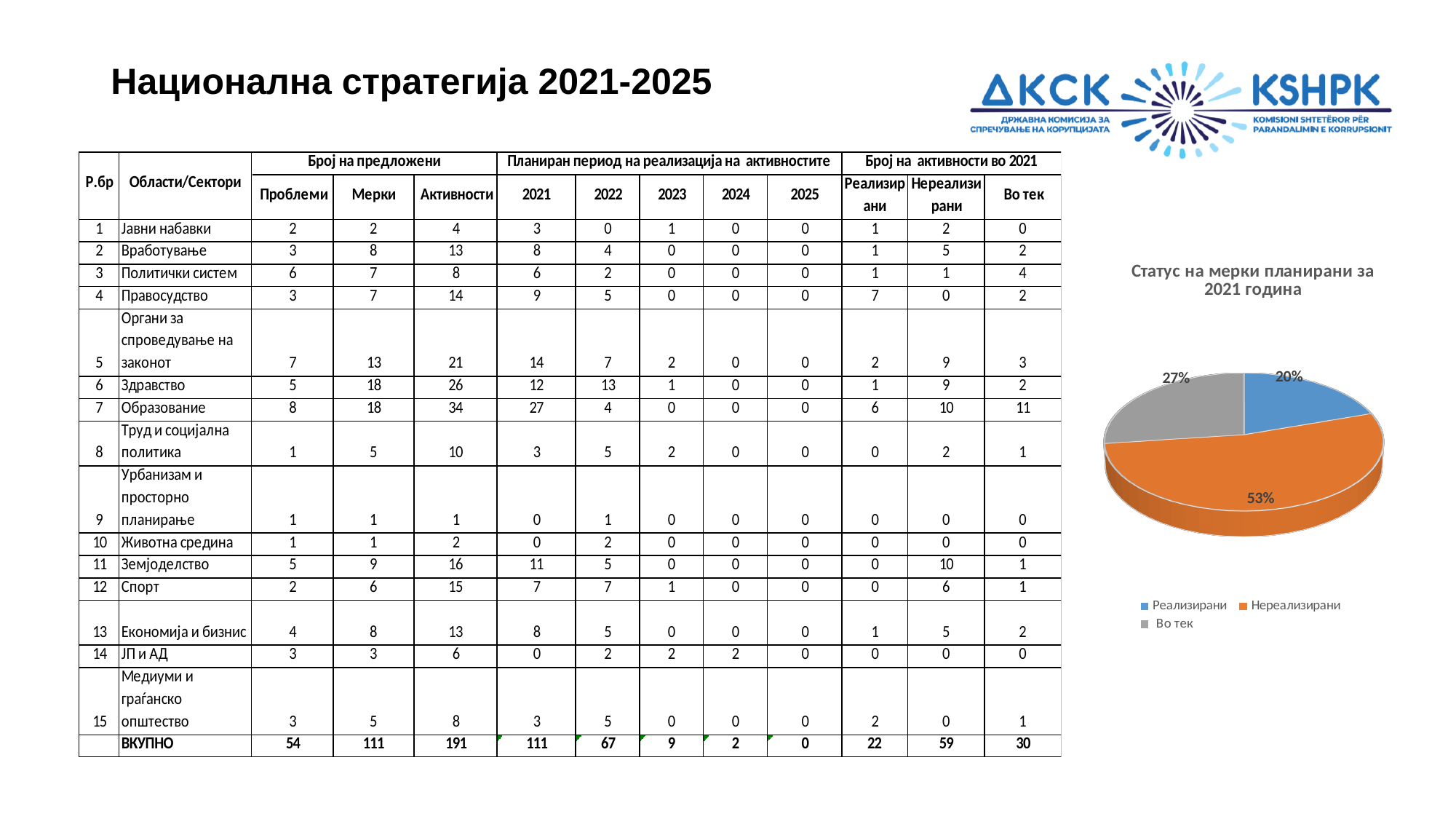
In the pie chart, what share is shown for Нереализирани? 53% How many entries does the pie chart legend list? 3 In the pie chart, what is the difference in percentage points between Нереализирани and Реализирани? 33 How many slices does the pie chart have? 3 Which slice of the pie chart is the smallest? Реализирани Which slice of the pie chart is the largest? Нереализирани In the pie chart, what share is shown for Во тек? 27% What colour is the Нереализирани slice in the pie chart? orange In the pie chart, what share is shown for Реализирани? 20% What is the title of the pie chart? Статус на мерки планирани за 2021 година What kind of chart is shown on the slide? pie chart In the pie chart, which is larger: Во тек or Реализирани? Во тек